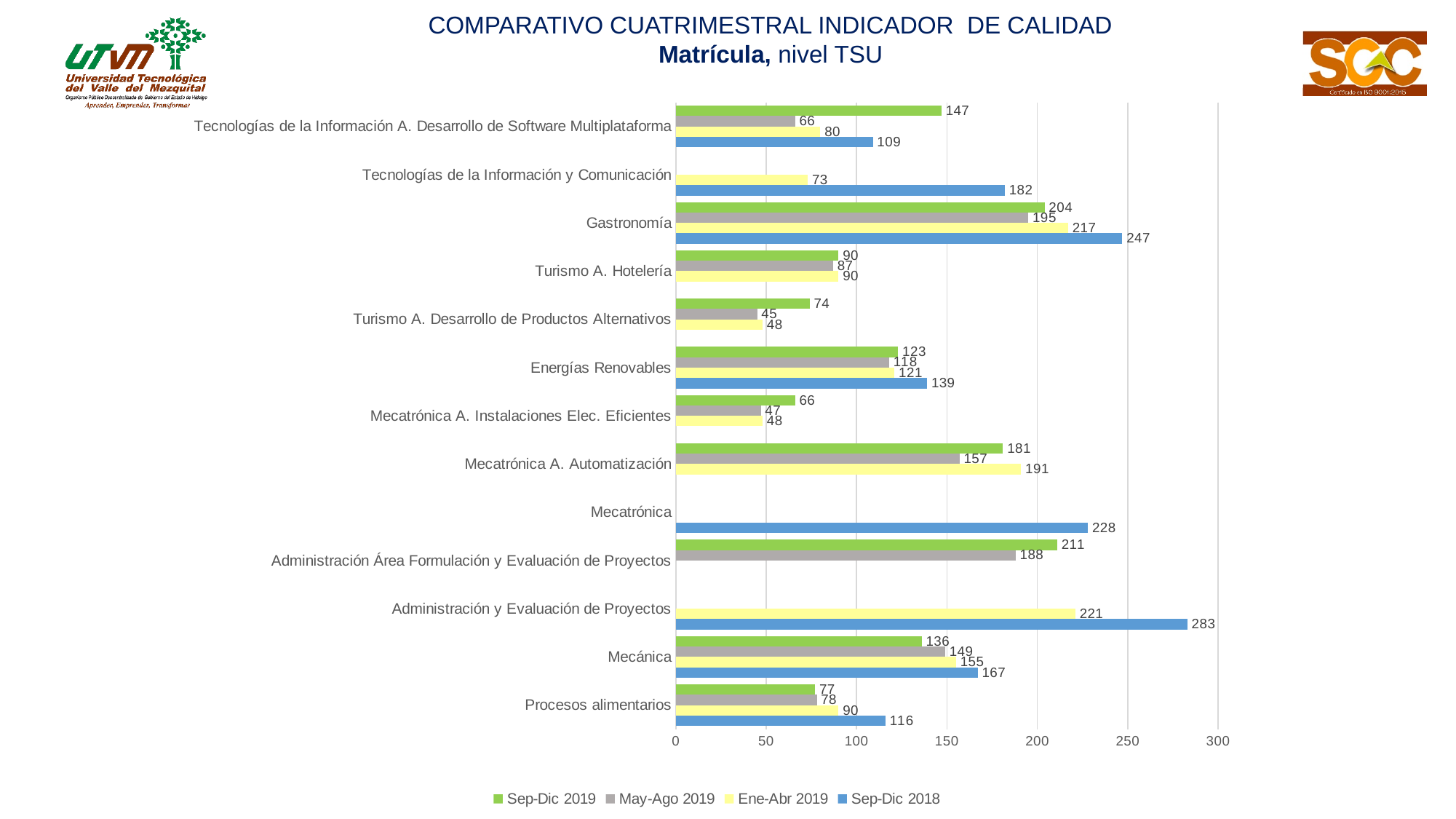
What is the Sep-Dic 2018 value for Gastronomía? 247 What is the difference between the Sep-Dic 2018 and Sep-Dic 2019 values for Mecánica? 31 What is the Ene-Abr 2019 value for Administración y Evaluación de Proyectos? 221 Which category has the highest Sep-Dic 2019 value? Administración Área Formulación y Evaluación de Proyectos What type of chart is shown on the slide? Bar chart What is the title of the chart? COMPARATIVO CUATRIMESTRAL INDICADOR DE CALIDAD Matrícula, nivel TSU What is the May-Ago 2019 value for Mecatrónica A. Automatización? 157 How many program categories are shown on the chart? 13 Which is larger for Energías Renovables: the Sep-Dic 2019 value or the Sep-Dic 2018 value? Sep-Dic 2018 How many series does the legend list? 4 Which series has the largest value for Tecnologías de la Información A. Desarrollo de Software Multiplataforma? Sep-Dic 2019 Which category has the lowest Sep-Dic 2019 value? Mecatrónica A. Instalaciones Elec. Eficientes